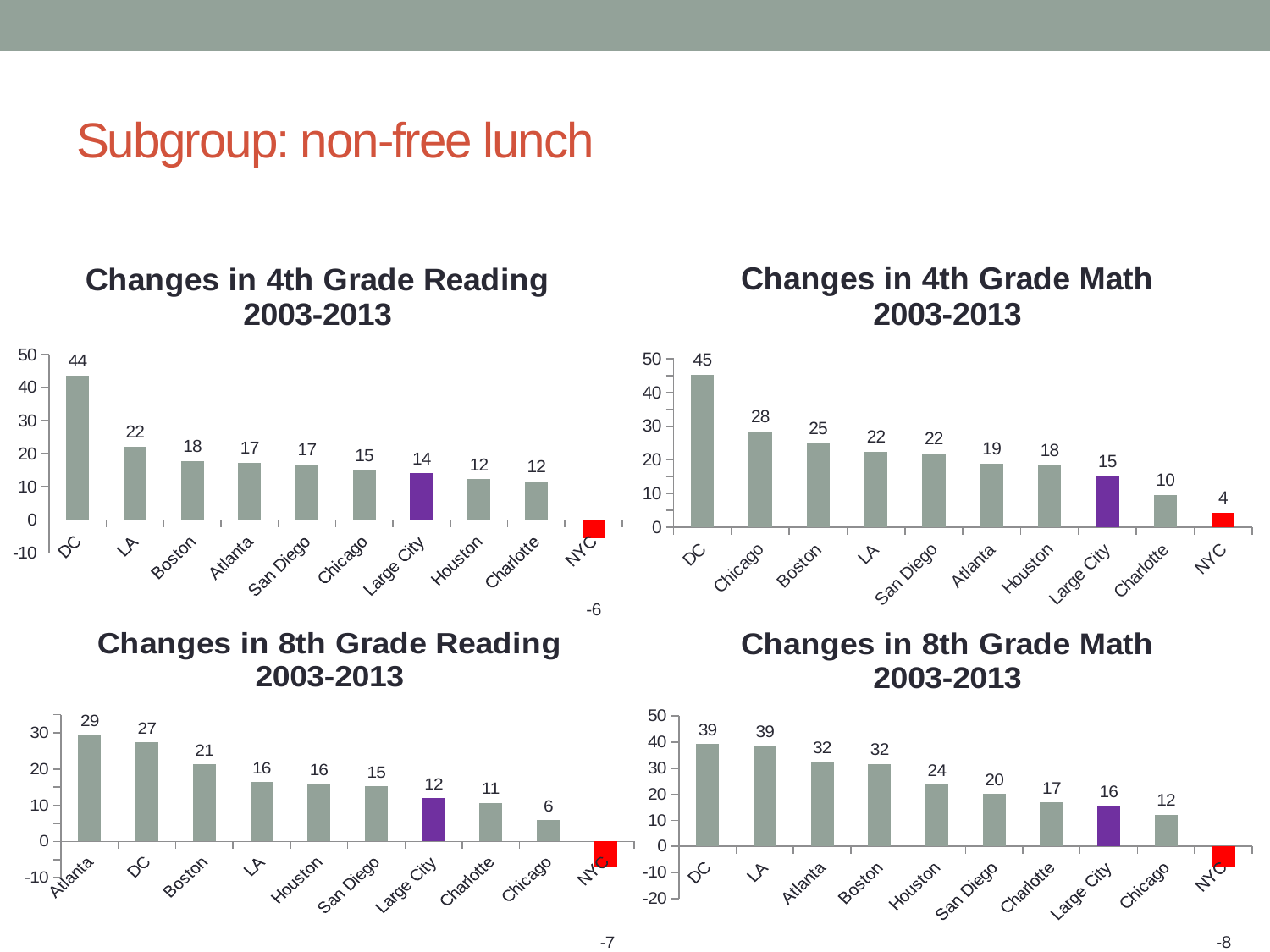
In the 'Changes in 8th Grade Math 2003-2013' chart, what is the value for Houston? 24 In the 'Changes in 4th Grade Reading 2003-2013' chart, which city has the lowest value? NYC In the 'Changes in 4th Grade Math 2003-2013' chart, what is the value for Chicago? 28 In the 'Changes in 4th Grade Math 2003-2013' chart, what is the difference between DC and Large City? 30 In the 'Changes in 8th Grade Reading 2003-2013' chart, which is larger, Boston or Chicago? Boston What kind of chart is 'Changes in 8th Grade Math 2003-2013'? Bar chart In the 'Changes in 4th Grade Reading 2003-2013' chart, what is the value for DC? 44 In the 'Changes in 8th Grade Reading 2003-2013' chart, what is the value for Atlanta? 29 In the 'Changes in 8th Grade Math 2003-2013' chart, what is the value for NYC? -8 In the 'Changes in 8th Grade Reading 2003-2013' chart, how many cities are shown? 10 In the 'Changes in 4th Grade Reading 2003-2013' chart, what is the value for NYC? -6 In the 'Changes in 4th Grade Math 2003-2013' chart, which city has the highest value? DC